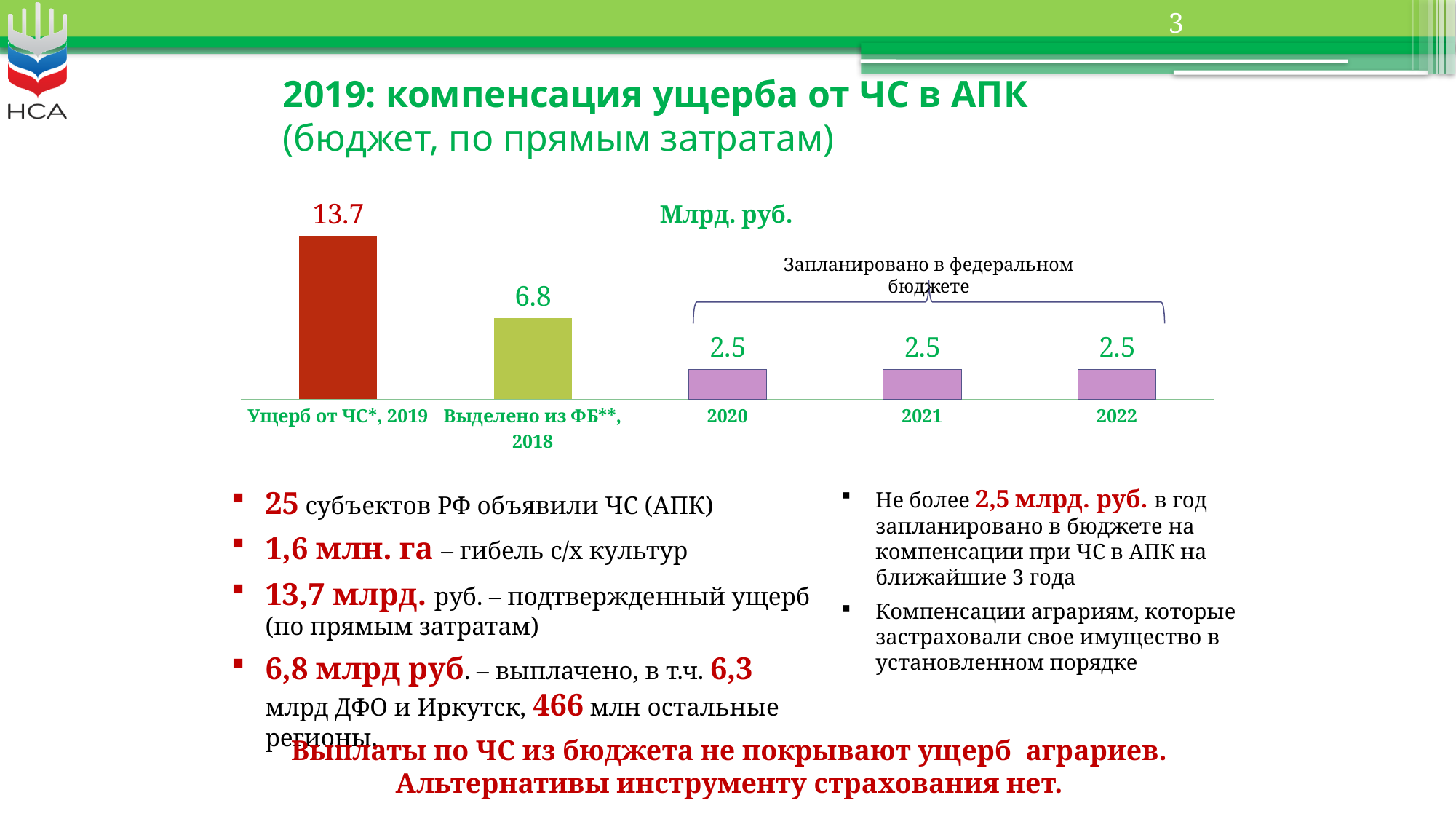
What type of chart is shown on the slide? Bar chart What is the value of the bar labelled "Выделено из ФБ**, 2018"? 6.8 What is the difference between the value for "Ущерб от ЧС*, 2019" and the value for "Выделено из ФБ**, 2018"? 6.9 Which is larger: the value for "Выделено из ФБ**, 2018" or the value for 2022? Выделено из ФБ**, 2018 What value is shown for 2021? 2.5 What is the difference between the value for "Выделено из ФБ**, 2018" and the value for 2020? 4.3 What unit is indicated for the values in the chart? Млрд. руб. How many bars are shown in the chart? 5 Which category has the highest value in the chart? Ущерб от ЧС*, 2019 Do the values for 2020, 2021 and 2022 rise, fall or stay the same? Stay the same What label is written above the bracket spanning the 2020–2022 bars? Запланировано в федеральном бюджете What is the value of the bar labelled "Ущерб от ЧС*, 2019"? 13.7